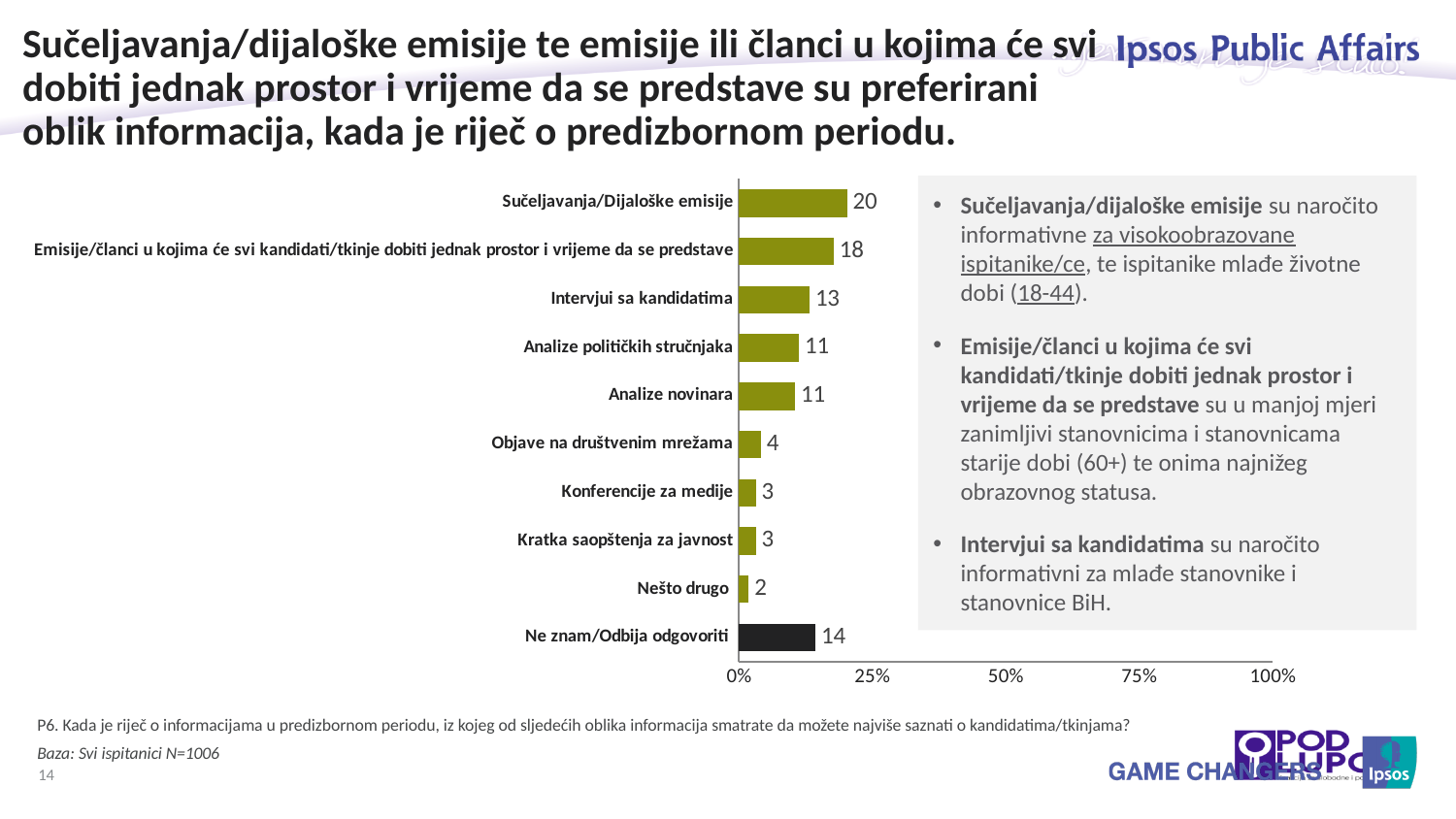
Is the value for Emisije/članci u kojima će svi kandidati/tkinje dobiti jednak prostor i vrijeme da se predstave greater or less than 25%? less How many categories are shown in the chart? 10 Which category has the lowest value? Nešto drugo What is the difference between the values for Sučeljavanja/Dijaloške emisije and Intervjui sa kandidatima? 7 What is the value for Intervjui sa kandidatima? 13 What kind of chart is shown on the slide? bar chart What is the value for Ne znam/Odbija odgovoriti? 14 What is the value for Sučeljavanja/Dijaloške emisije? 20 What is the value for Analize političkih stručnjaka? 11 Which is larger, the value for Analize novinara or the value for Konferencije za medije? Analize novinara Which category has the highest value? Sučeljavanja/Dijaloške emisije What is the value for Objave na društvenim mrežama? 4